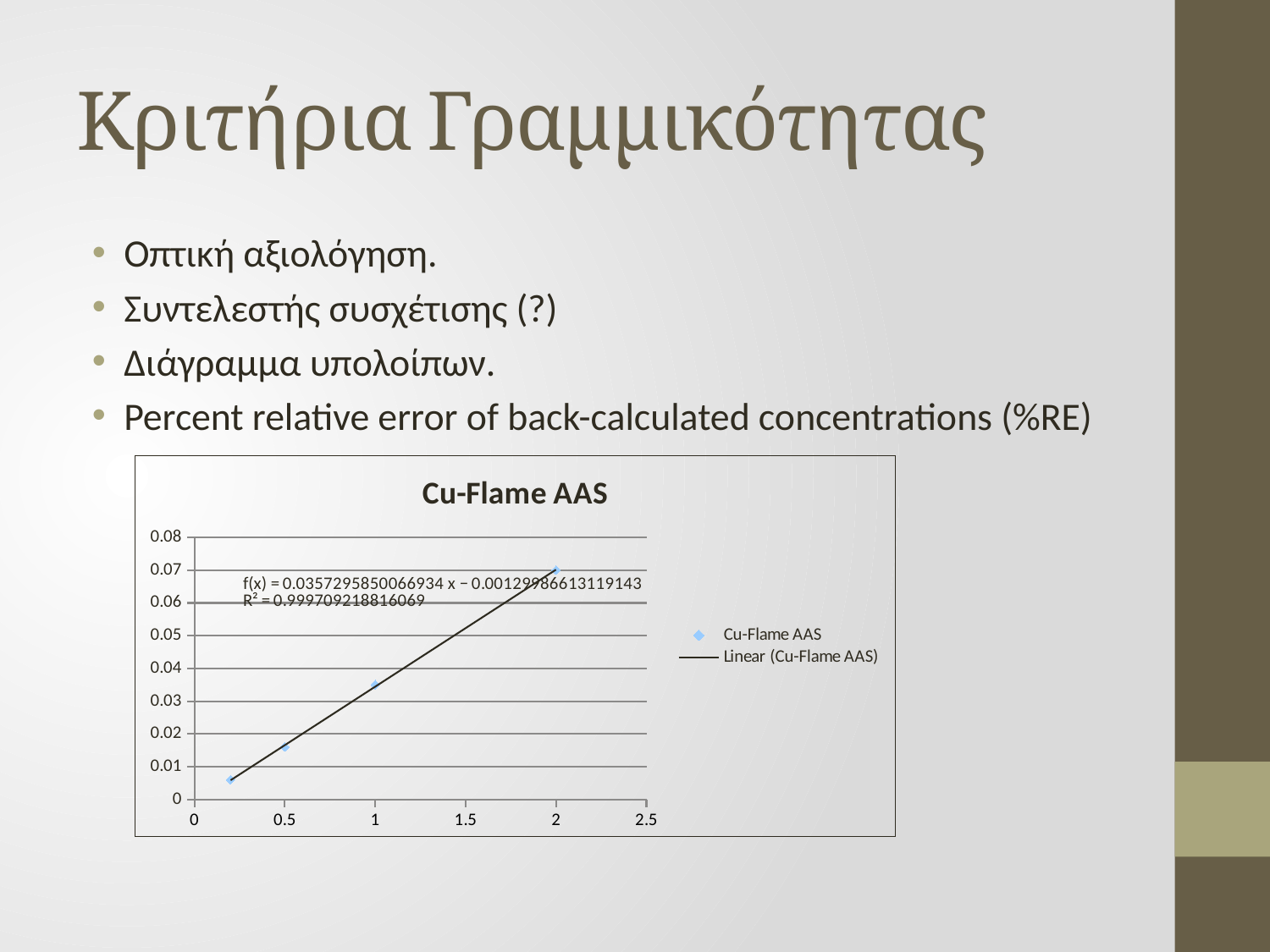
What is the highest tick value shown on the y axis? 0.08 What kind of chart is shown on the slide? scatter chart What is the title of the chart? Cu-Flame AAS How many entries does the chart legend list? 2 How many data points are plotted in the Cu-Flame AAS chart? 4 Is the value of the data point at x = 2 greater or less than 0.06? greater Do the plotted values rise or fall as x increases along the x axis? rise Which data point has the highest value, the one at x = 2 or the one at x = 1? x = 2 Is the value of the data point at x = 1 greater or less than 0.04? less Is the value of the data point at x = 0.2 greater or less than 0.01? less What R² value is printed on the chart? 0.999709218816069